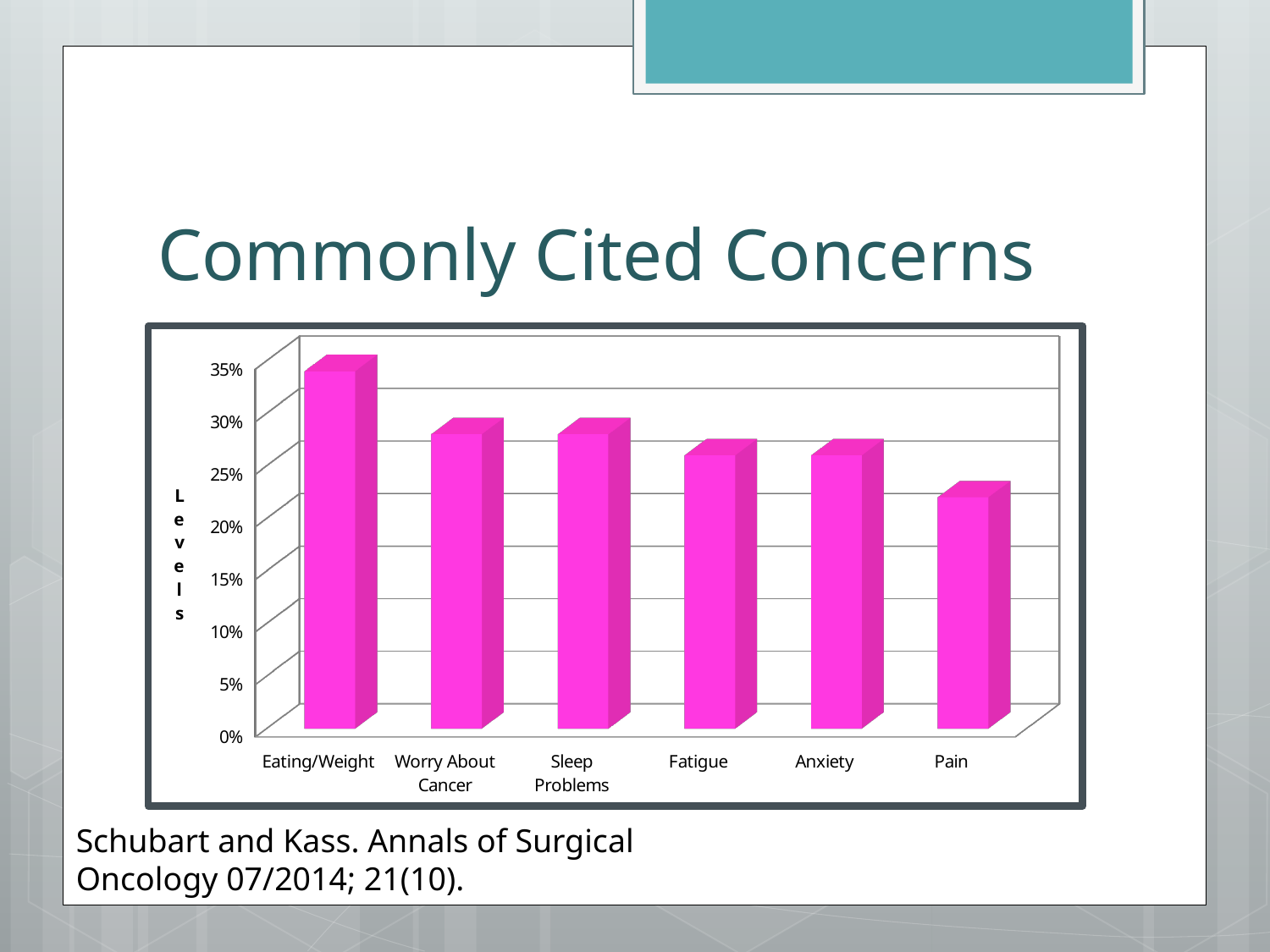
How many concern categories are plotted on the chart? 6 Is the value for Worry About Cancer greater or less than 25%? greater Is the value for Fatigue greater or less than 30%? less Do the values generally rise or fall moving from left to right across the categories? fall What kind of chart is shown on the slide? bar chart Which concern has the highest value on the chart? Eating/Weight Which is larger, the value for Eating/Weight or the value for Pain? Eating/Weight Which concern has the lowest value on the chart? Pain Which is larger, the value for Sleep Problems or the value for Pain? Sleep Problems What is the title of the slide containing the chart? Commonly Cited Concerns Is the value for Eating/Weight greater or less than 30%? greater